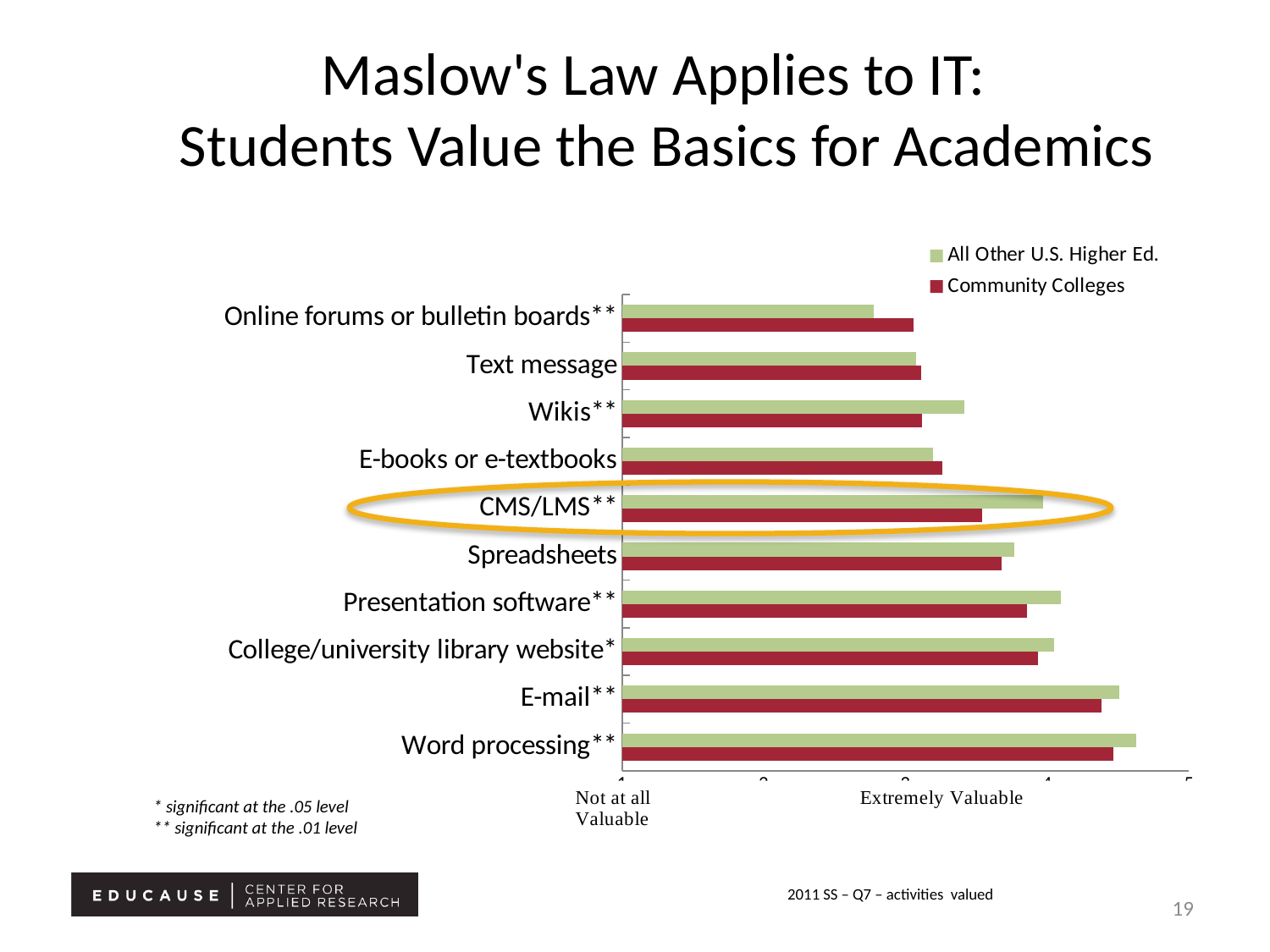
Which category has the lowest value for All Other U.S. Higher Ed.? Online forums or bulletin boards** Is the Community Colleges value for E-mail** greater or less than 4? greater Which category has the highest value for All Other U.S. Higher Ed.? Word processing** Is the Community Colleges value for Spreadsheets greater or less than 4? less For Online forums or bulletin boards**, which series has the larger value, All Other U.S. Higher Ed. or Community Colleges? Community Colleges What kind of chart is shown on the slide? bar chart How many categories are plotted on the chart? 10 Is the All Other U.S. Higher Ed. value for Online forums or bulletin boards** greater or less than 3? less How many series does the legend list? 2 For Wikis**, which series has the larger value, All Other U.S. Higher Ed. or Community Colleges? All Other U.S. Higher Ed. Which category on the chart is highlighted with an orange circle? CMS/LMS**